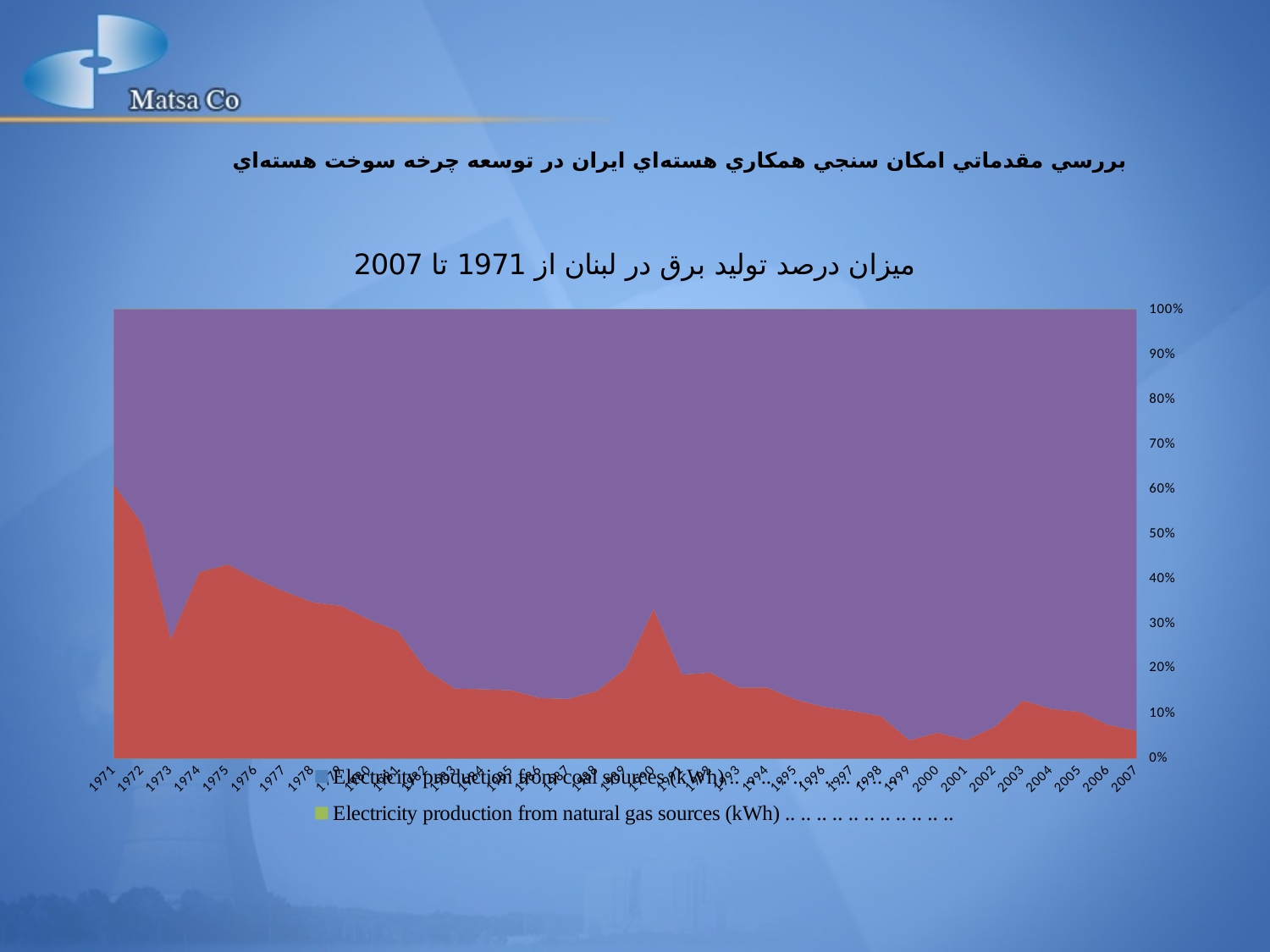
Is the value of the lower (red) area in 1971 greater or less than 50%? greater Is the value of the lower (red) area in 1985 greater or less than 20%? less Is the value of the lower (red) area in 1990 greater or less than 20%? greater Does the share of the lower (red) area generally rise or fall from 1971 to 2007? fall In which year does the lower (red) area reach its highest share? 1971 What kind of chart is shown on the slide? Area chart What is the last year shown on the x axis? 2007 What is the first year shown on the x axis? 1971 How many years are plotted along the x axis? 37 Is the share of the lower (red) area larger in 1975 or in 1985? 1975